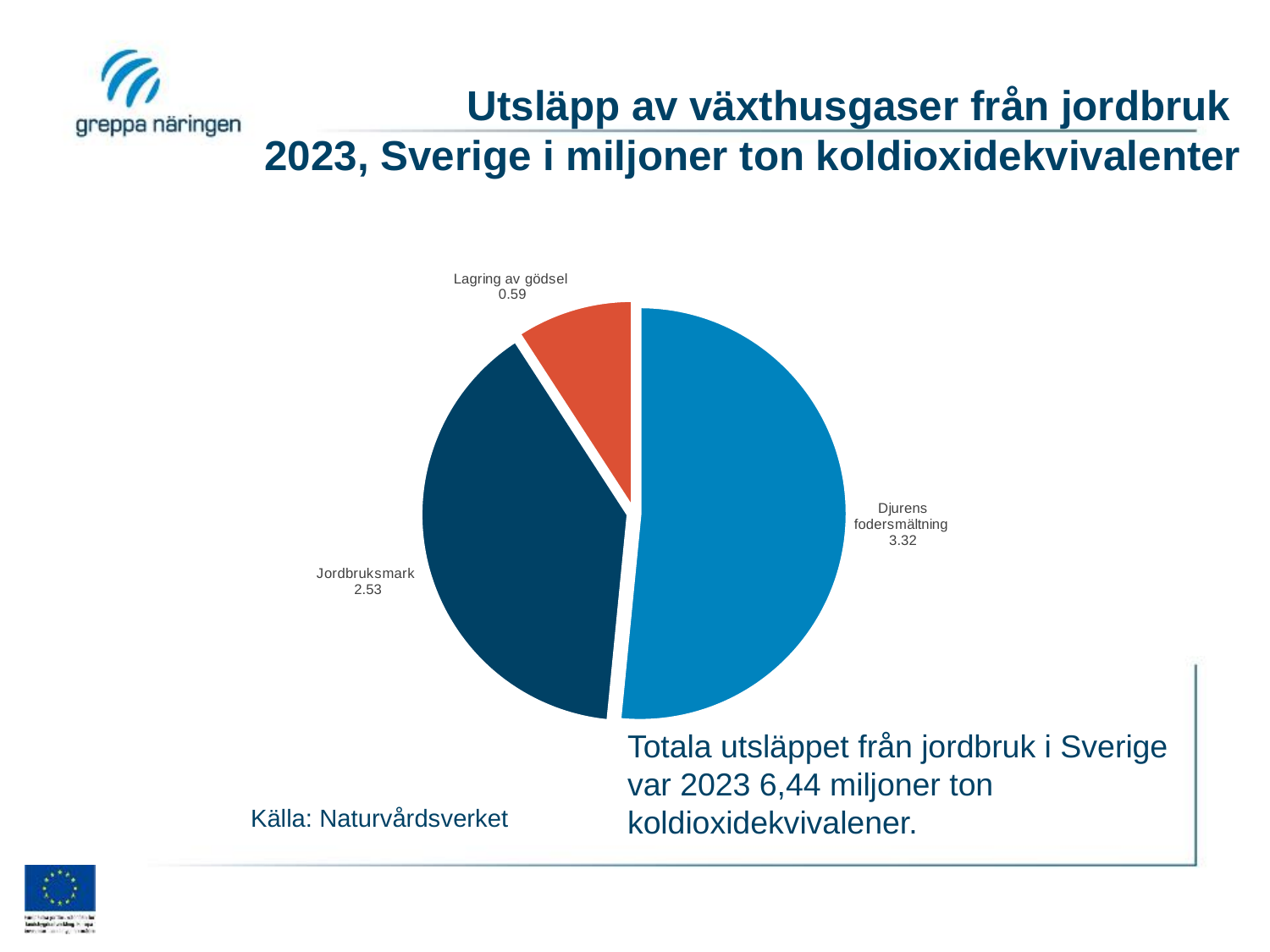
What is the value for Lagring av gödsel? 0.59 What is the difference between the values for Djurens fodersmältning and Jordbruksmark? 0.79 What is the value for Djurens fodersmältning? 3.32 Which is larger, the value for Jordbruksmark or the value for Lagring av gödsel? Jordbruksmark What is the value for Jordbruksmark? 2.53 What type of chart is shown on the slide? Pie chart What is the difference between the values for Jordbruksmark and Lagring av gödsel? 1.94 What is the total of all slices in the pie chart? 6.44 Which category has the smallest slice of the pie? Lagring av gödsel What is the source cited for the chart data? Naturvårdsverket Which category has the largest slice of the pie? Djurens fodersmältning How many categories are shown in the pie chart? 3